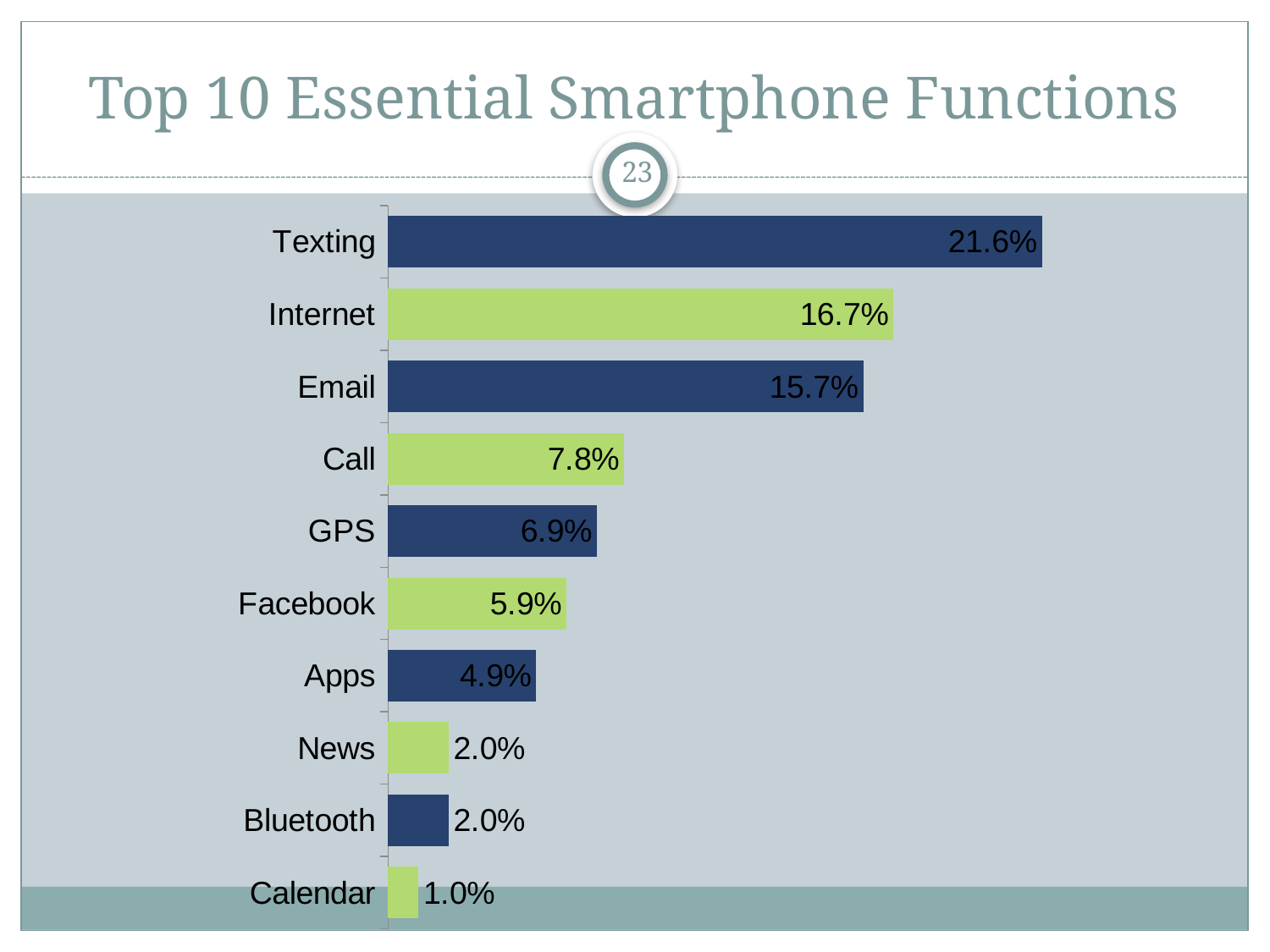
Which function has the lowest value? Calendar How many functions are shown in the chart? 10 What is the value for Email? 15.7% Which is larger, the value for Facebook or the value for Apps? Facebook What kind of chart is shown on the slide? Bar chart What is the value for Calendar? 1.0% Which function has the highest value? Texting What is the title of the slide? Top 10 Essential Smartphone Functions What is the value for Texting? 21.6% What is the difference between the values for Texting and Internet? 4.9% What is the value for GPS? 6.9% What is the difference between the values for Call and Apps? 2.9%